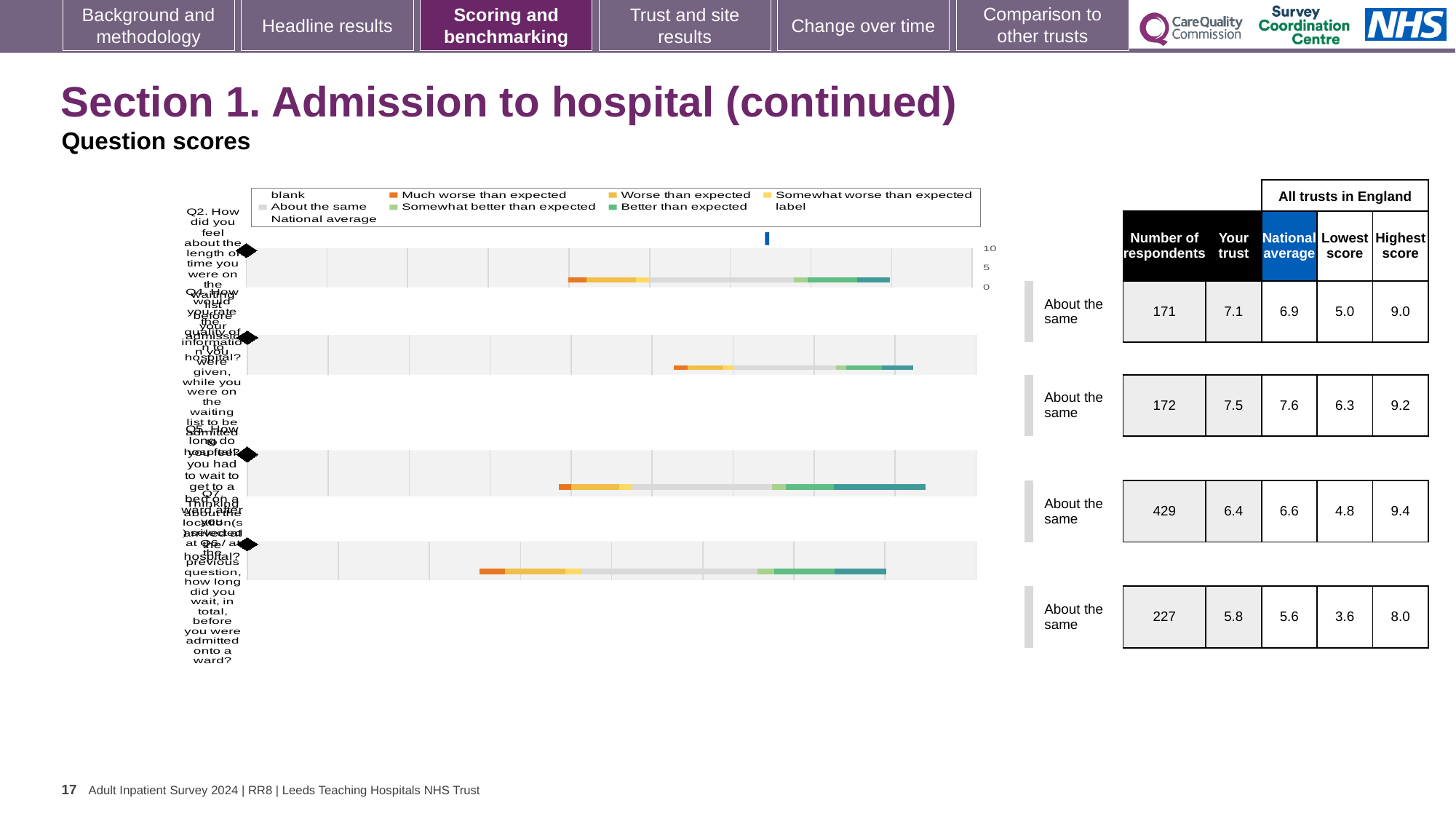
What is the difference between the national average and the 'Your trust' score for Q5 (the third row)? 0.2 What benchmark category is shown for every question on the slide? About the same How many questions (bars) are plotted in the chart? 4 What is the 'Your trust' score for Q2 (the first row)? 7.1 What is the highest score across all trusts in England for Q4 (the second row)? 9.2 Which row has the highest 'Your trust' score? Q4 (second row), 7.5 What is the national average for Q7 (the last row)? 5.6 What is the number of respondents for Q5 (the third row)? 429 What kind of chart is shown on the slide? bar chart Which row has the lowest 'Lowest score' value? Q7 (last row), 3.6 What is the difference between the highest score and the lowest score for Q7 (the last row)? 4.4 For Q2 (the first row), which is larger: the 'Your trust' score or the national average? Your trust